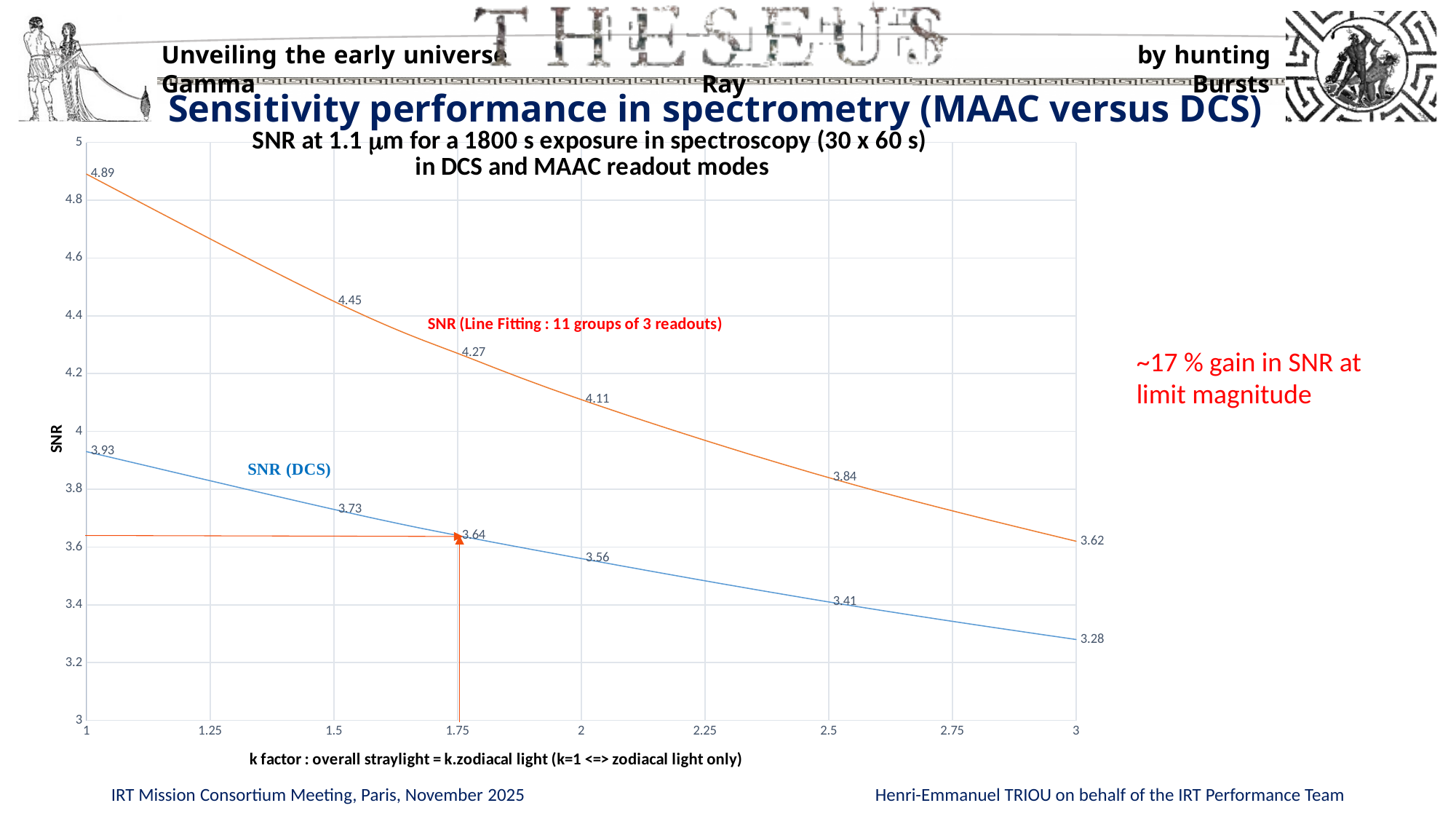
What kind of chart is shown on the slide? line chart What is the SNR (Line Fitting) value at k factor 1? 4.89 How many data series (lines) are plotted on the chart? 2 What is the SNR (DCS) value at k factor 1.75? 3.64 What is the label of the y axis? SNR Which series has the higher SNR at k factor 2.5, Line Fitting or DCS? SNR (Line Fitting) What is the SNR (Line Fitting) value at k factor 3? 3.62 Is the SNR (Line Fitting) value at k factor 1.5 greater or less than 4.4? greater What is the SNR (DCS) value at k factor 1? 3.93 Do the SNR values rise or fall as the k factor increases? fall What is the SNR (DCS) value at k factor 3? 3.28 What is the difference between the SNR (Line Fitting) and SNR (DCS) values at k factor 2? 0.55